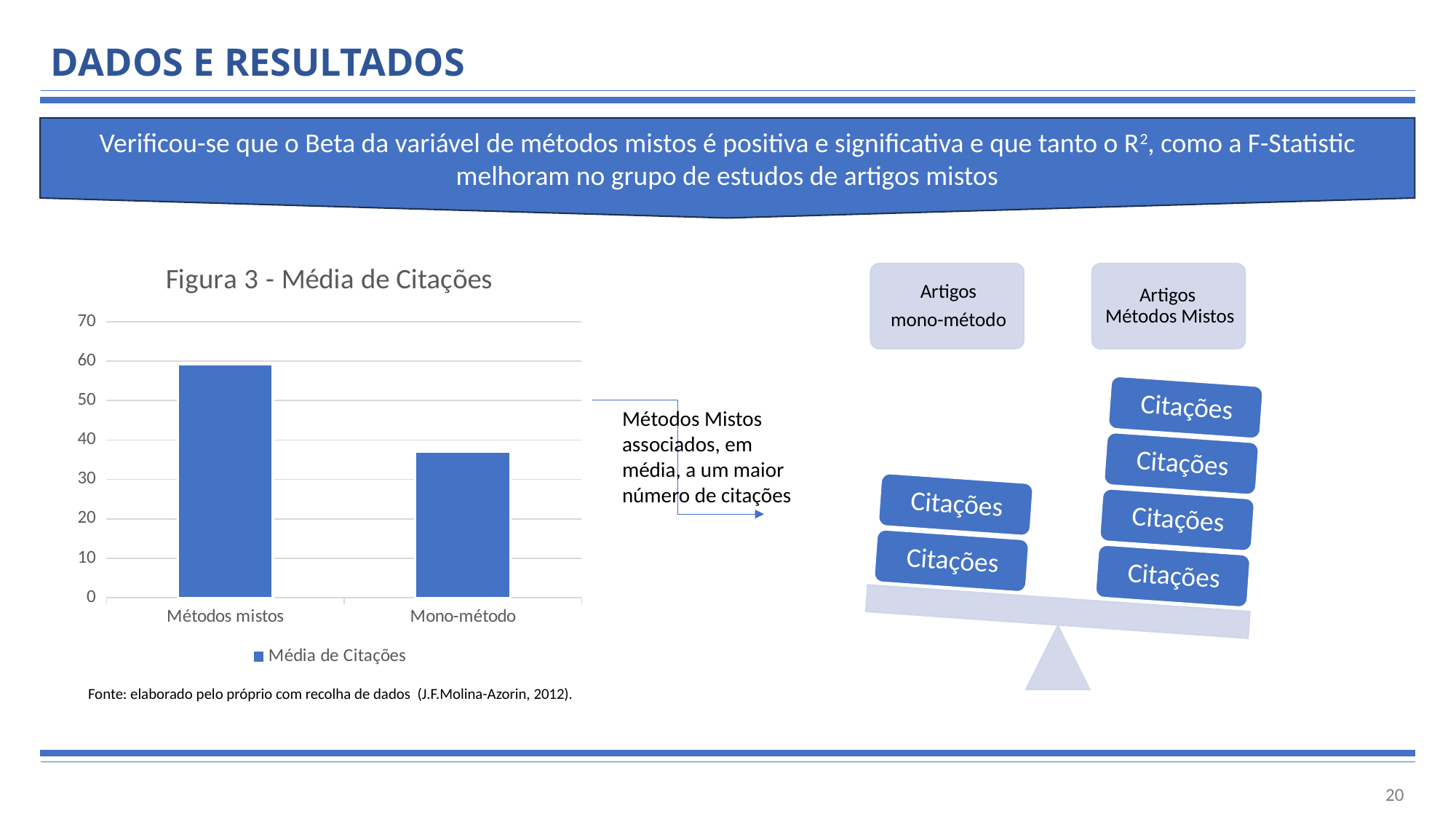
What series name is shown in the chart legend? Média de Citações Which category has the highest value in the chart? Métodos mistos Is the value for Métodos mistos greater or less than 50? greater How many categories are shown on the x axis of the chart? 2 Which category has the lowest value in the chart? Mono-método What is the title of the chart? Figura 3 - Média de Citações How many series does the chart legend list? 1 Is the value for Métodos mistos greater or less than 70? less Is the value for Mono-método greater or less than 30? greater What kind of chart is Figura 3 - Média de Citações? bar chart Which is larger, the value for Métodos mistos or the value for Mono-método? Métodos mistos